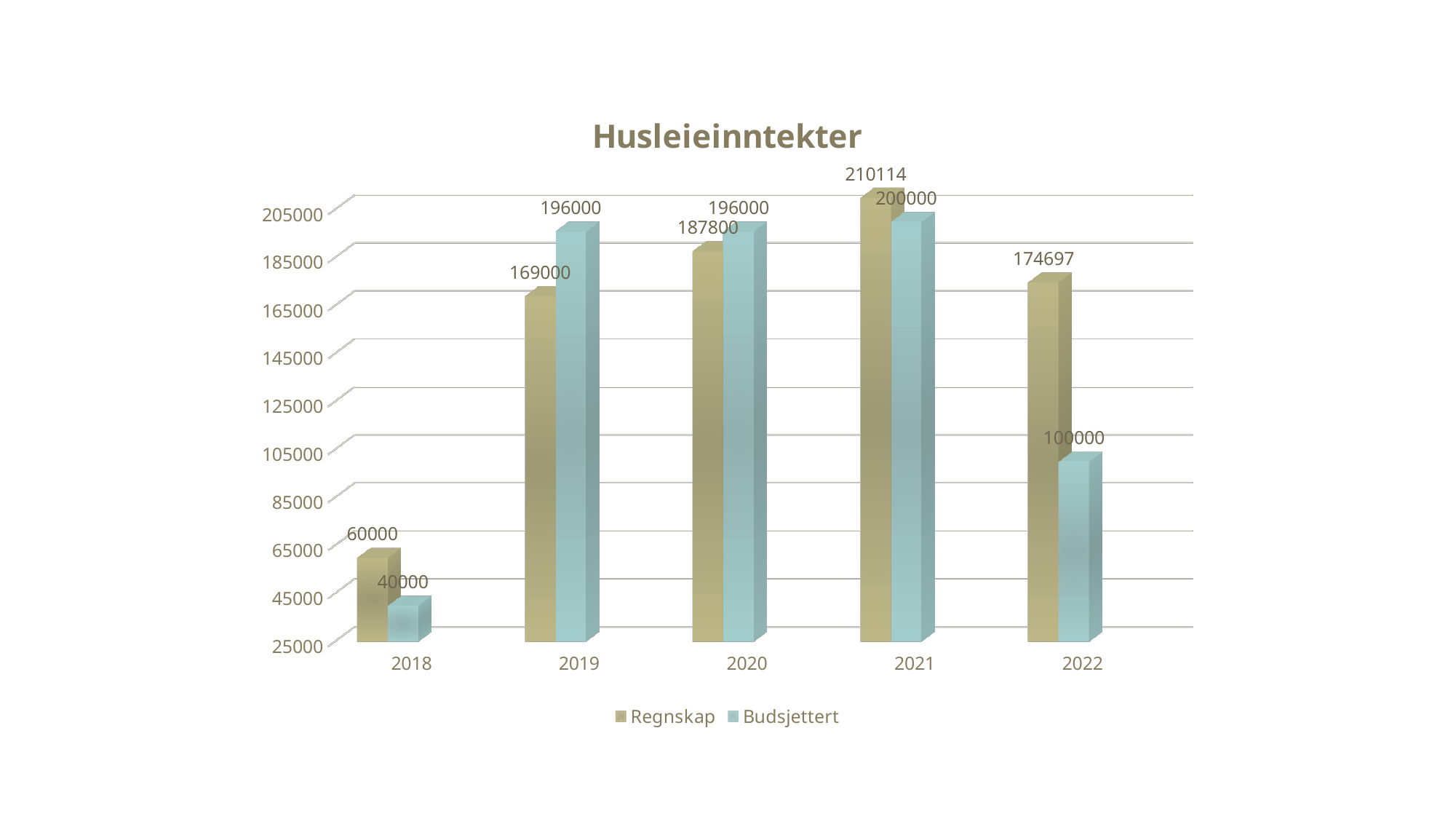
Which is larger in 2020, Regnskap or Budsjettert? Budsjettert Which year has the highest Regnskap value? 2021 Which year has the lowest Budsjettert value? 2018 What kind of chart is this? bar chart How many years are shown on the x axis? 5 What is the Budsjettert value for 2022? 100000 How many series does the legend list? 2 What is the difference between the Regnskap and Budsjettert values for 2022? 74697 What is the title of the chart? Husleieinntekter What is the Regnskap value for 2021? 210114 What is the difference between the Budsjettert and Regnskap values for 2019? 27000 What is the Regnskap value for 2020? 187800